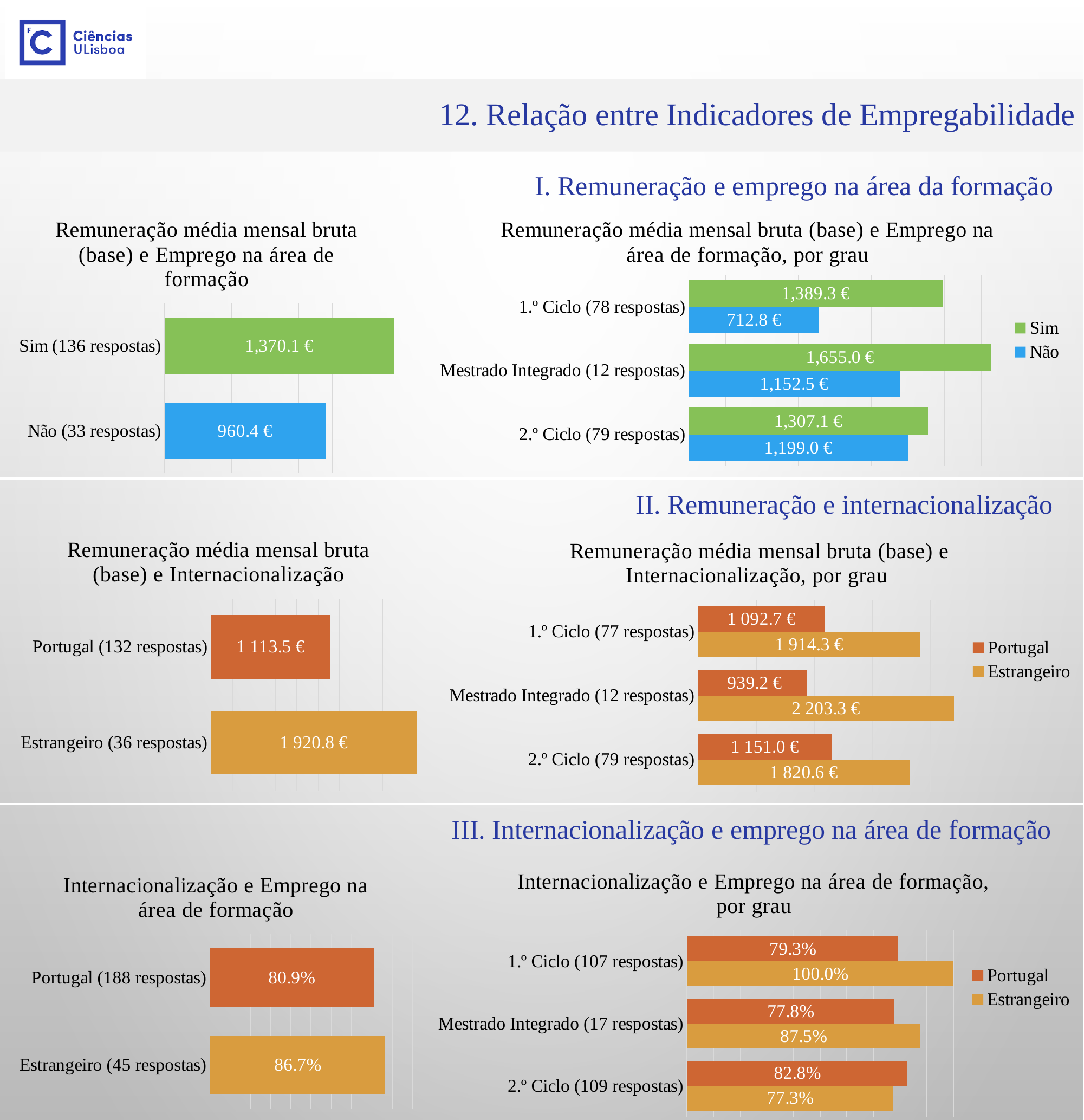
In the middle-right chart 'Remuneração média mensal bruta (base) e Internacionalização, por grau', what is the Estrangeiro value for Mestrado Integrado (12 respostas)? 2 203.3 € In the top-left chart 'Remuneração média mensal bruta (base) e Emprego na área de formação', what is the value for Sim (136 respostas)? 1,370.1 € In the top-left chart 'Remuneração média mensal bruta (base) e Emprego na área de formação', what is the difference between the Sim and Não values? 409.7 € In the middle-left chart 'Remuneração média mensal bruta (base) e Internacionalização', what kind of chart is shown? Bar chart In the bottom-right chart 'Internacionalização e Emprego na área de formação, por grau', how many categories are shown on the vertical axis? 3 In the top-right chart 'Remuneração média mensal bruta (base) e Emprego na área de formação, por grau', how many series does the legend list? 2 In the middle-right chart 'Remuneração média mensal bruta (base) e Internacionalização, por grau', which category has the lowest Portugal value? Mestrado Integrado (12 respostas) In the top-right chart 'Remuneração média mensal bruta (base) e Emprego na área de formação, por grau', which category has the highest Sim value? Mestrado Integrado (12 respostas) In the bottom-left chart 'Internacionalização e Emprego na área de formação', which is larger, the value for Portugal (188 respostas) or Estrangeiro (45 respostas)? Estrangeiro (45 respostas) In the top-right chart 'Remuneração média mensal bruta (base) e Emprego na área de formação, por grau', what is the Não value for 1.º Ciclo (78 respostas)? 712.8 € In the bottom-right chart 'Internacionalização e Emprego na área de formação, por grau', what is the Estrangeiro value for 1.º Ciclo (107 respostas)? 100.0% In the middle-left chart 'Remuneração média mensal bruta (base) e Internacionalização', what is the value for Estrangeiro (36 respostas)? 1 920.8 €